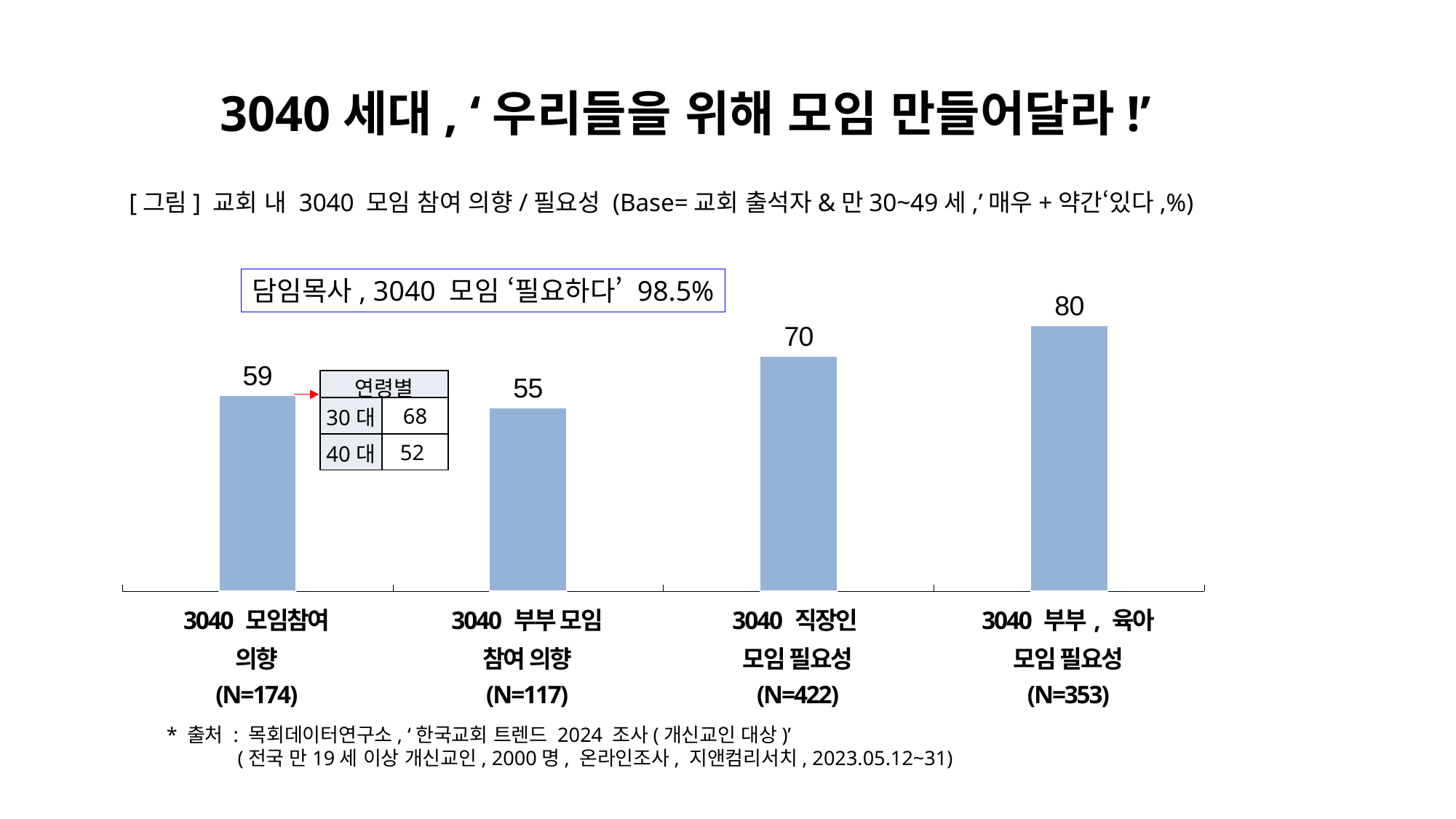
What kind of chart is shown on the slide? Bar chart How many categories are shown in the chart? 4 What is the value for '3040 부부 모임 참여 의향 (N=117)'? 55 What is the value for '3040 부부, 육아 모임 필요성 (N=353)'? 80 Which category has the lowest value? 3040 부부 모임 참여 의향 (N=117) What is the value for '3040 모임참여 의향 (N=174)'? 59 In the inset table by age group (연령별), what is the value for 30대? 68 According to the boxed note on the chart, what percentage of 담임목사 said a 3040 모임 is '필요하다'? 98.5% What is the difference between the values for '3040 부부, 육아 모임 필요성' and '3040 모임참여 의향'? 21 Which category has the highest value? 3040 부부, 육아 모임 필요성 (N=353) What is the value for '3040 직장인 모임 필요성 (N=422)'? 70 Which is larger: the value for '3040 직장인 모임 필요성' or '3040 부부 모임 참여 의향'? 3040 직장인 모임 필요성